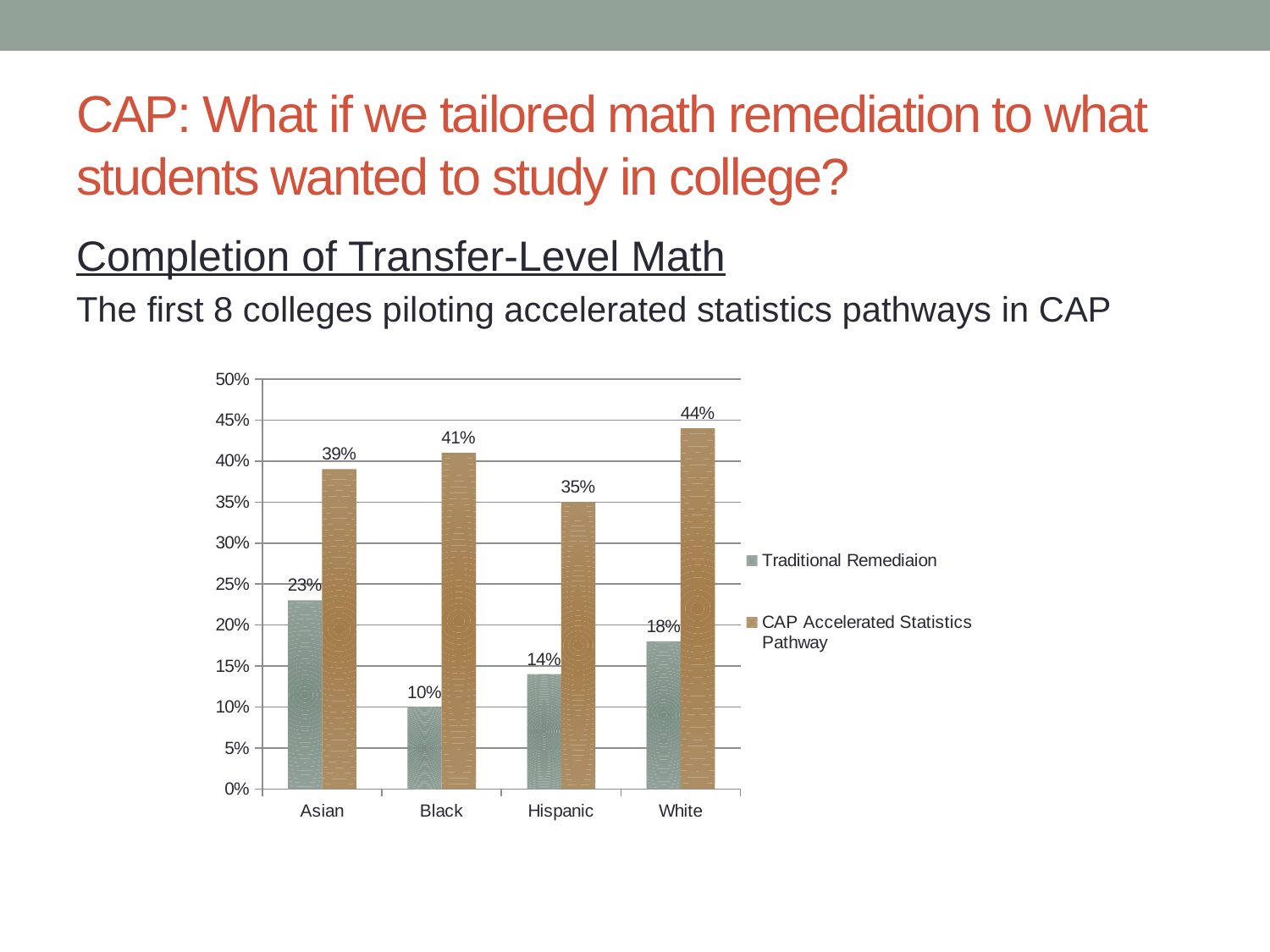
What is the CAP Accelerated Statistics Pathway value for Hispanic students? 35% Which is larger: the Traditional Remediaion value for White students or for Hispanic students? White What kind of chart is shown on the slide? Bar chart What is the Traditional Remediaion value for Asian students? 23% What is the Traditional Remediaion value for Black students? 10% What is the difference between the CAP Accelerated Statistics Pathway and Traditional Remediaion values for Black students? 31% Which category has the lowest Traditional Remediaion value? Black Which category has the highest CAP Accelerated Statistics Pathway value? White How many series does the legend list? 2 Is the CAP Accelerated Statistics Pathway value for Black students greater or less than 40%? greater What is the difference between the CAP Accelerated Statistics Pathway values for White and Asian students? 5% How many categories are shown on the x axis? 4